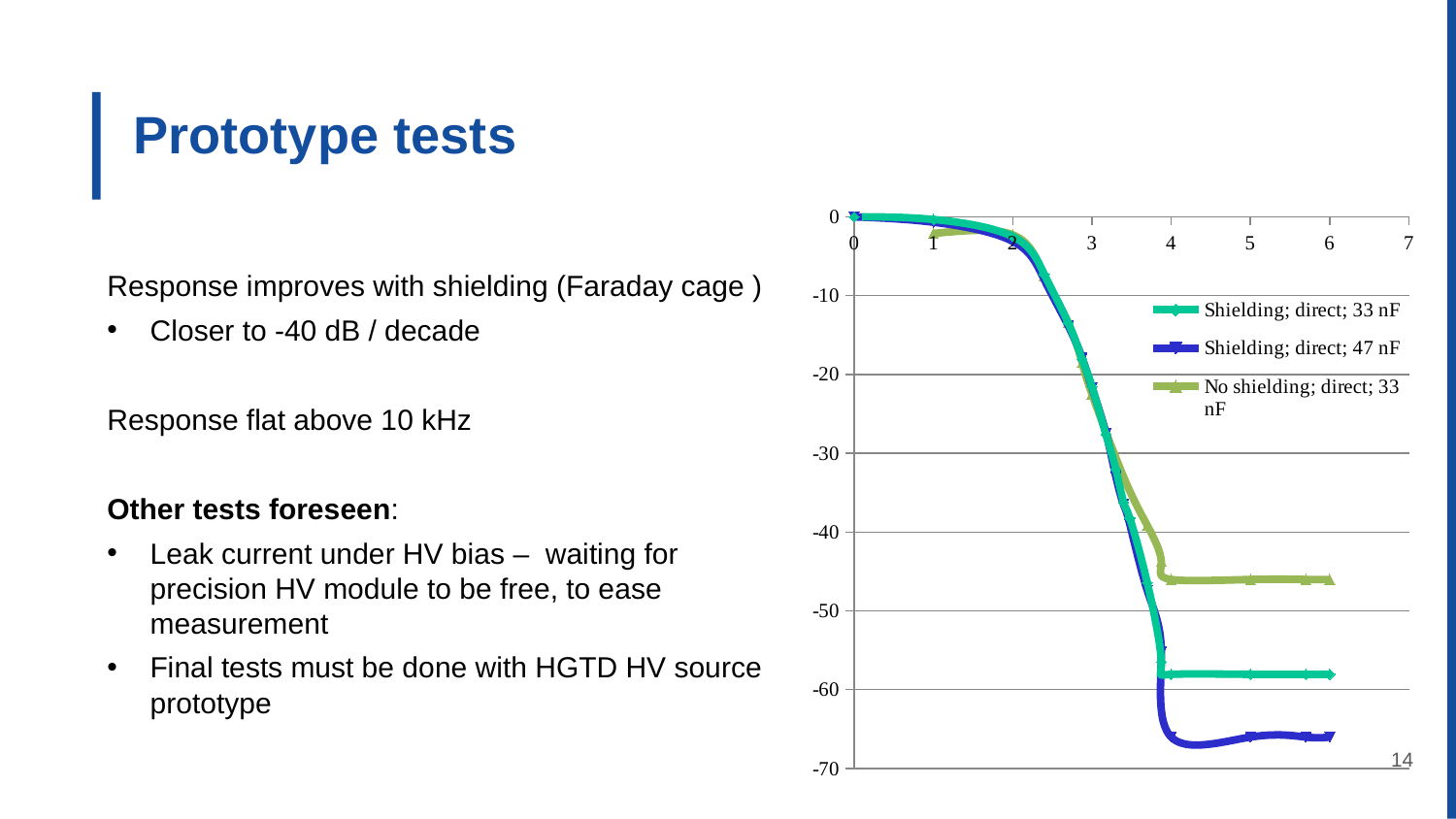
How many series does the chart legend list? 3 What is the lowest value shown on the chart's vertical axis? -70 Is the value of the No shielding; direct; 33 nF series at x = 6 greater or less than -50? greater What are the three series named in the chart legend? Shielding; direct; 33 nF, Shielding; direct; 47 nF, No shielding; direct; 33 nF Do the plotted values rise or fall as the x axis increases from 0 to 4? fall Is the value of the Shielding; direct; 33 nF series at x = 6 greater or less than -50? less Which series has the highest value at x = 6? No shielding; direct; 33 nF What kind of chart is shown on the slide? line chart At x = 6, which series has the larger value: Shielding; direct; 33 nF or Shielding; direct; 47 nF? Shielding; direct; 33 nF Is the value of the Shielding; direct; 47 nF series at x = 6 greater or less than -60? less Which series has the lowest value at x = 6? Shielding; direct; 47 nF